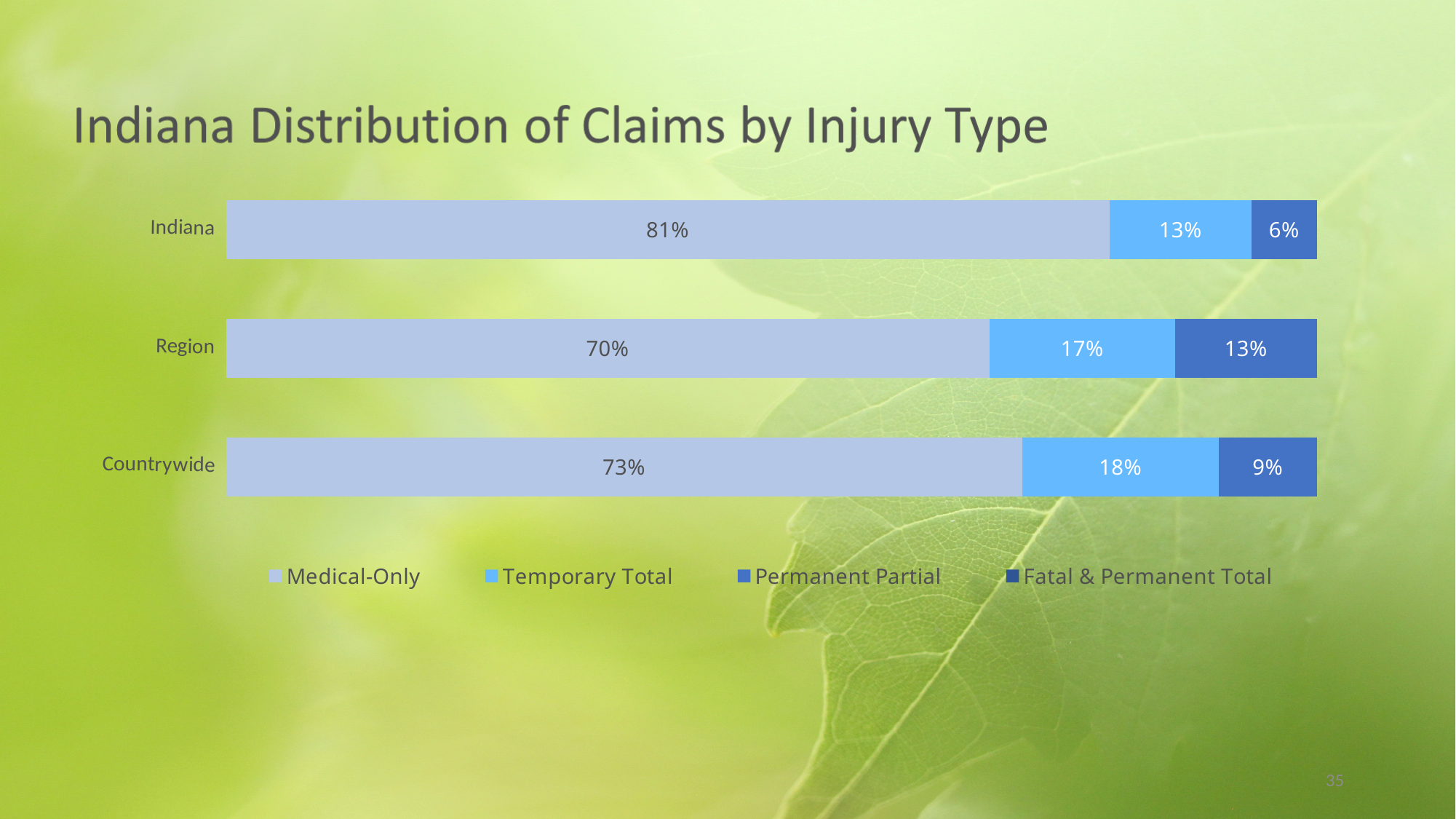
How many series does the legend list? 4 What is the Permanent Partial share for Region? 13% What is the title of the chart? Indiana Distribution of Claims by Injury Type What kind of chart is shown on the slide? Stacked bar chart How many categories are shown on the chart? 3 What is the Permanent Partial share for Countrywide? 9% Which category has the highest Medical-Only share? Indiana What is the Medical-Only share for Indiana? 81% Which has a larger Temporary Total share, Countrywide or Indiana? Countrywide Which category has the lowest Permanent Partial share? Indiana What is the Temporary Total share for Region? 17% What is the difference between the Medical-Only share for Indiana and for Region? 11 percentage points